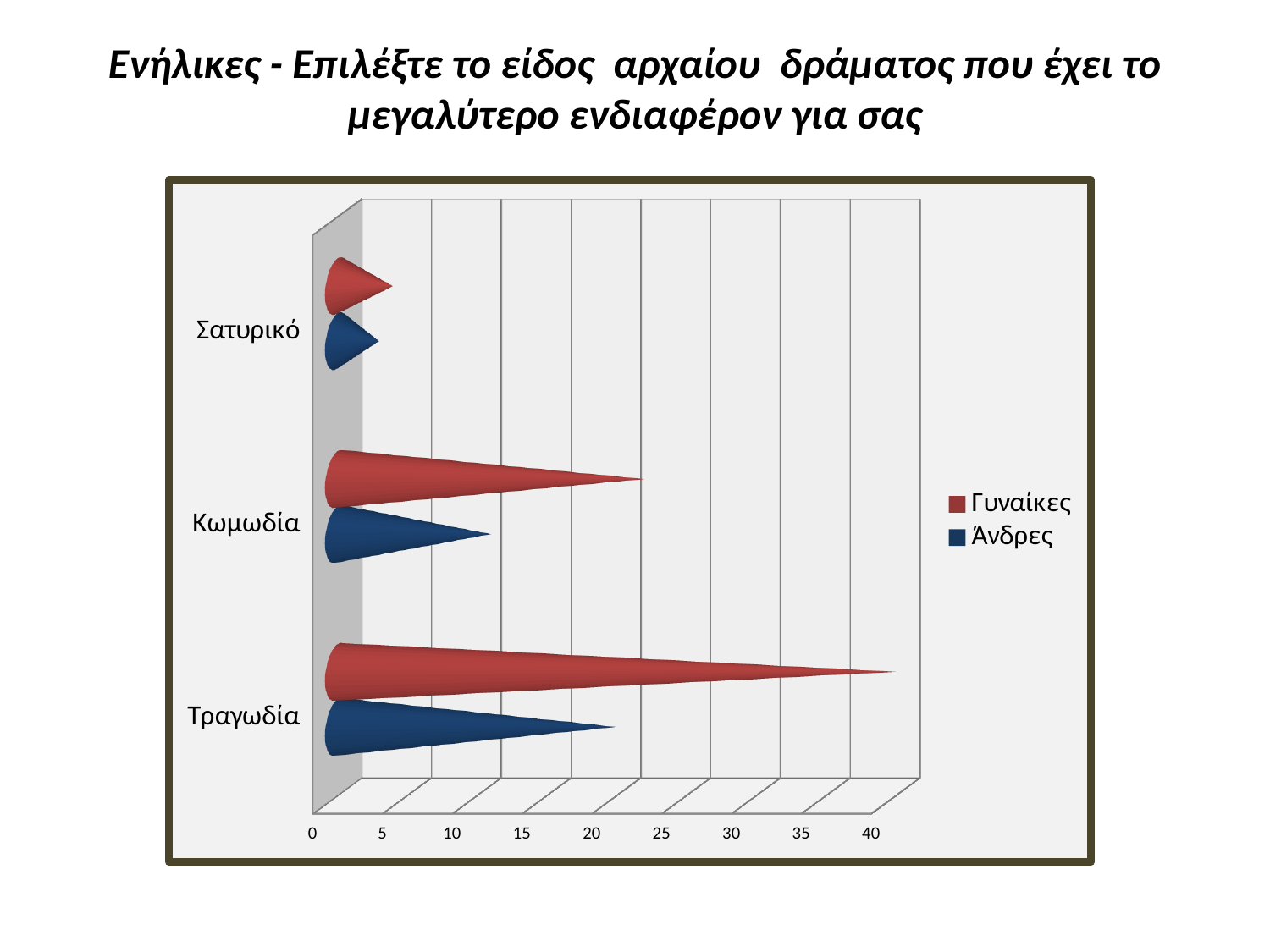
How many categories are shown on the chart? 3 What kind of chart is shown on the slide? bar chart For Κωμωδία, which is larger: the value for Γυναίκες or the value for Άνδρες? Γυναίκες Which category has the lowest value for Άνδρες? Σατυρικό Which category has the highest value for Άνδρες? Τραγωδία Which category has the highest value for Γυναίκες? Τραγωδία Is the value for Γυναίκες in Τραγωδία greater or less than 35? greater Which colour represents the Άνδρες series in the legend? blue Is the value for Γυναίκες in Σατυρικό greater or less than 10? less Is the value for Άνδρες in Κωμωδία greater or less than 15? less For Τραγωδία, which is larger: the value for Γυναίκες or the value for Άνδρες? Γυναίκες How many series does the legend list? 2